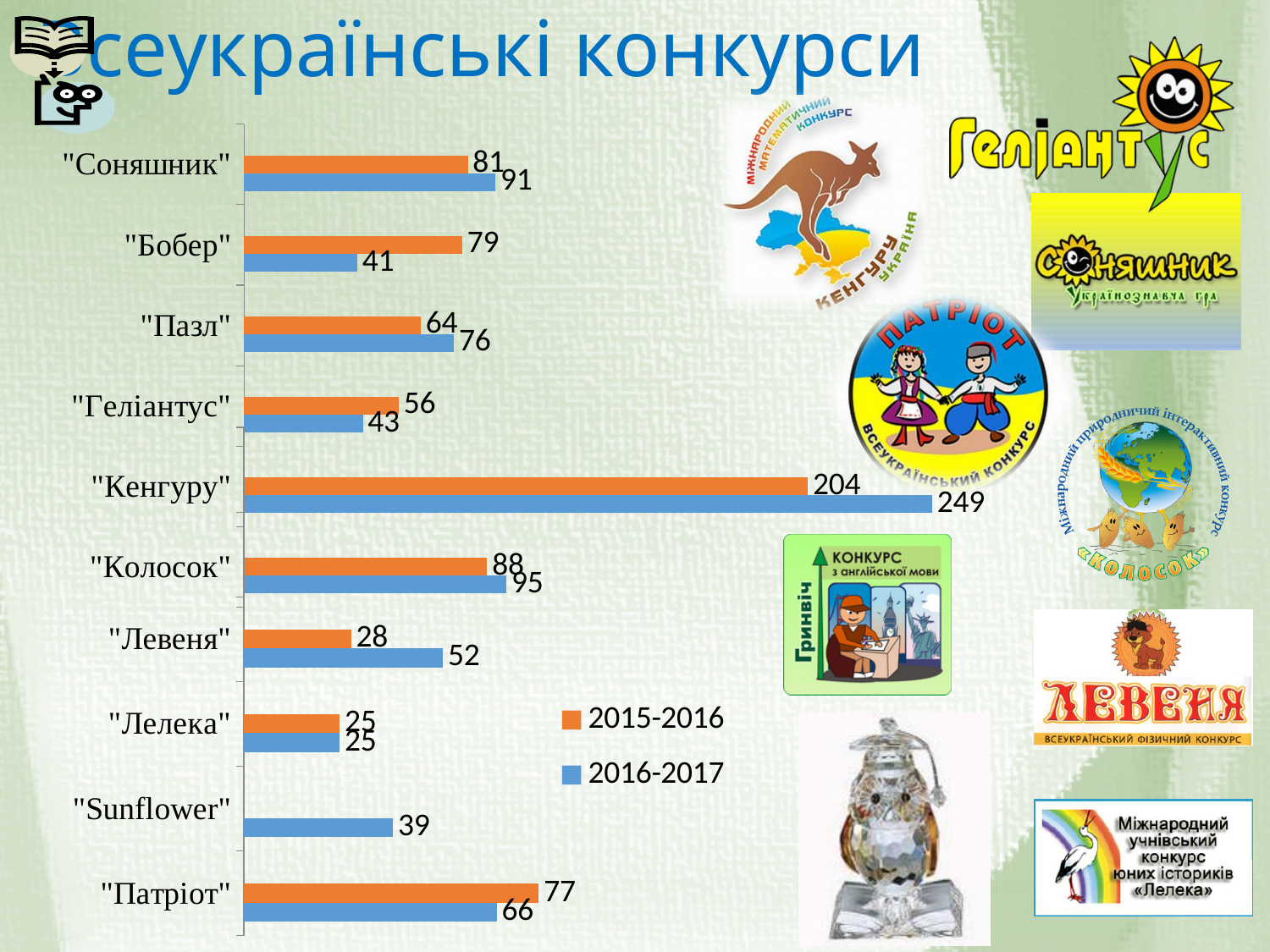
Which category has the highest value in the 2015-2016 series? "Кенгуру" What is the difference between the 2016-2017 and 2015-2016 values for "Кенгуру"? 45 How many series does the legend list? 2 What is the value for "Sunflower" in the 2016-2017 series? 39 How many categories are shown on the chart? 10 What is the difference between the 2015-2016 and 2016-2017 values for "Бобер"? 38 Which is larger for "Патріот": the 2015-2016 value or the 2016-2017 value? 2015-2016 What is the value for "Бобер" in the 2015-2016 series? 79 What is the value for "Кенгуру" in the 2016-2017 series? 249 Which is larger for "Левеня": the 2015-2016 value or the 2016-2017 value? 2016-2017 What kind of chart is shown on the slide? Bar chart Which category has the lowest value in the 2015-2016 series? "Лелека"